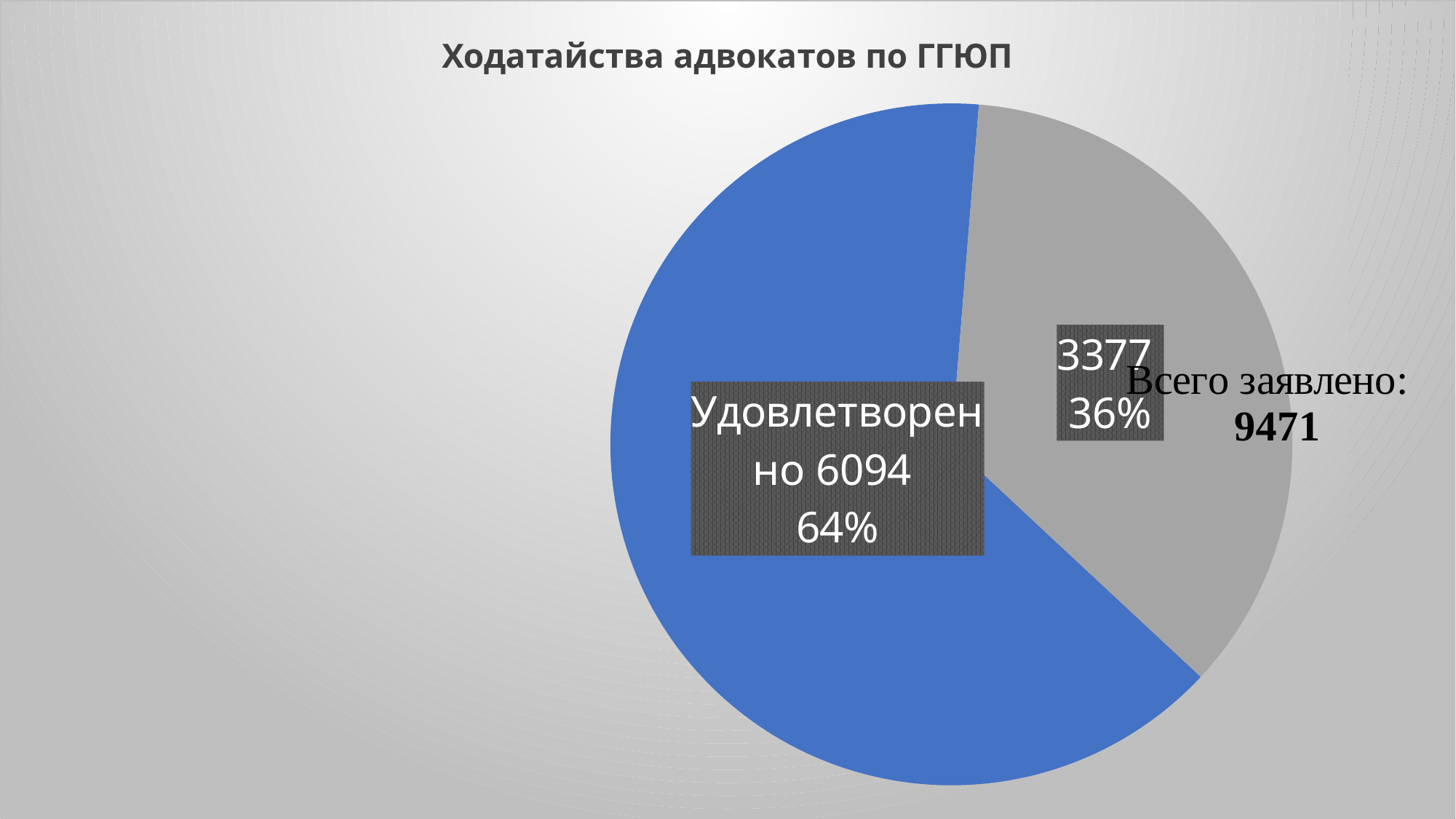
What value is shown on the grey slice of the pie? 3377 What total number of petitions (Всего заявлено) is stated on the slide? 9471 Which slice of the pie is the smallest? the grey slice (3377) How many slices does the pie chart have? 2 What is the value shown for the slice labelled Удовлетворено? 6094 Which slice is larger, the blue Удовлетворено slice or the grey slice? Удовлетворено What is the difference between the Удовлетворено value (6094) and the grey slice value (3377)? 2717 What colour is the Удовлетворено slice? blue What is the title of the chart? Ходатайства адвокатов по ГГЮП What kind of chart is shown on the slide? pie chart What percentage share does the grey slice have? 36% What percentage share does the Удовлетворено slice have? 64%